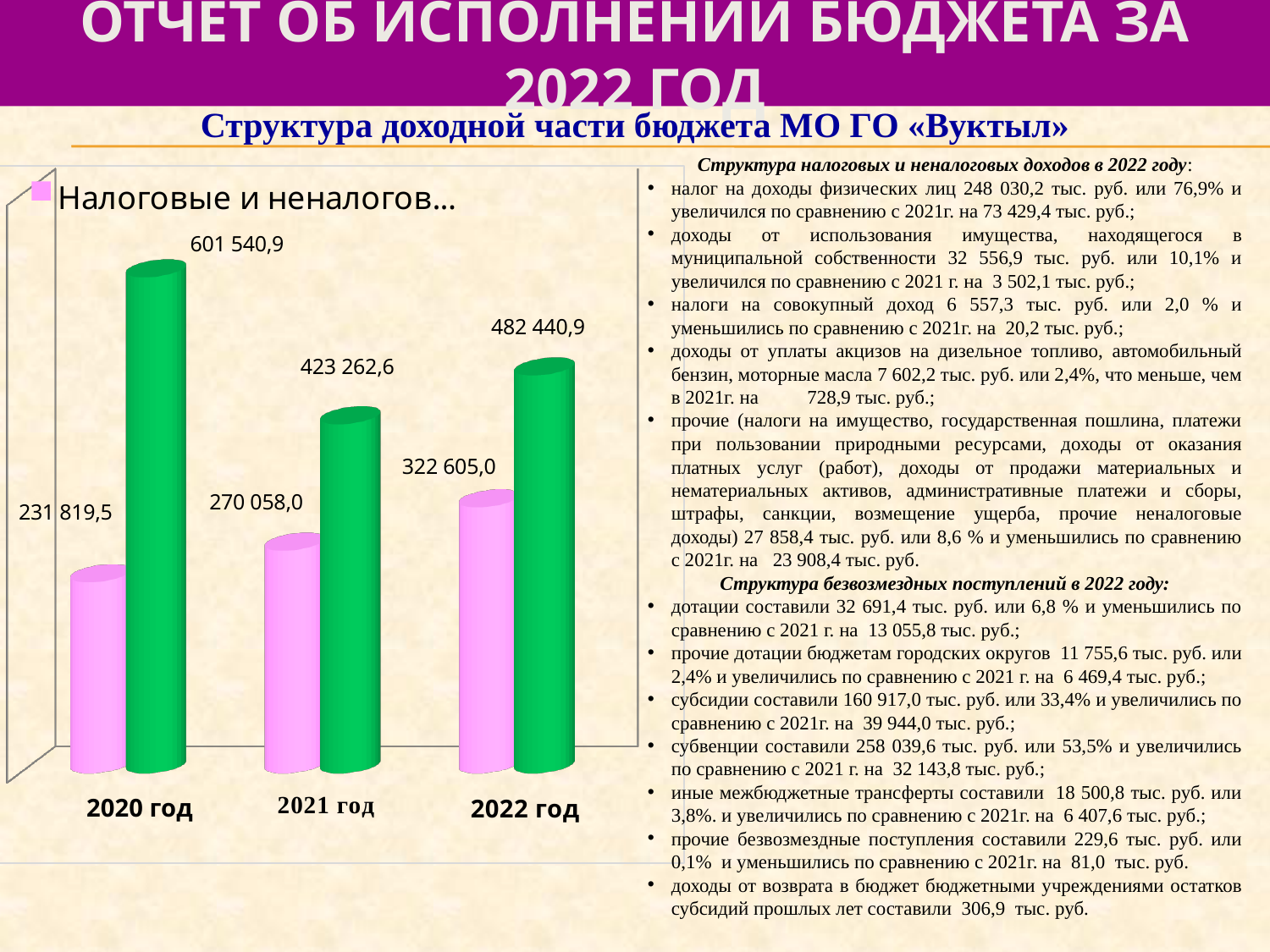
What is the value of the green bar for 2020 год? 601 540,9 For 2021 год, which bar is larger, the green one or the pink one? the green one What is the difference between the green bar for 2020 год and the green bar for 2022 год? 119 100,0 What kind of chart is shown on the slide? bar chart What is the value of the pink bar for 2022 год? 322 605,0 What is the value of the pink bar for 2020 год? 231 819,5 Do the pink bars rise or fall from 2020 год to 2022 год? rise In which year is the green bar the highest? 2020 год By how much does the pink bar for 2022 год exceed the pink bar for 2021 год? 52 547,0 How many years (categories) are shown on the x axis of the chart? 3 What is the value of the green bar for 2021 год? 423 262,6 In which year is the pink bar the lowest? 2020 год